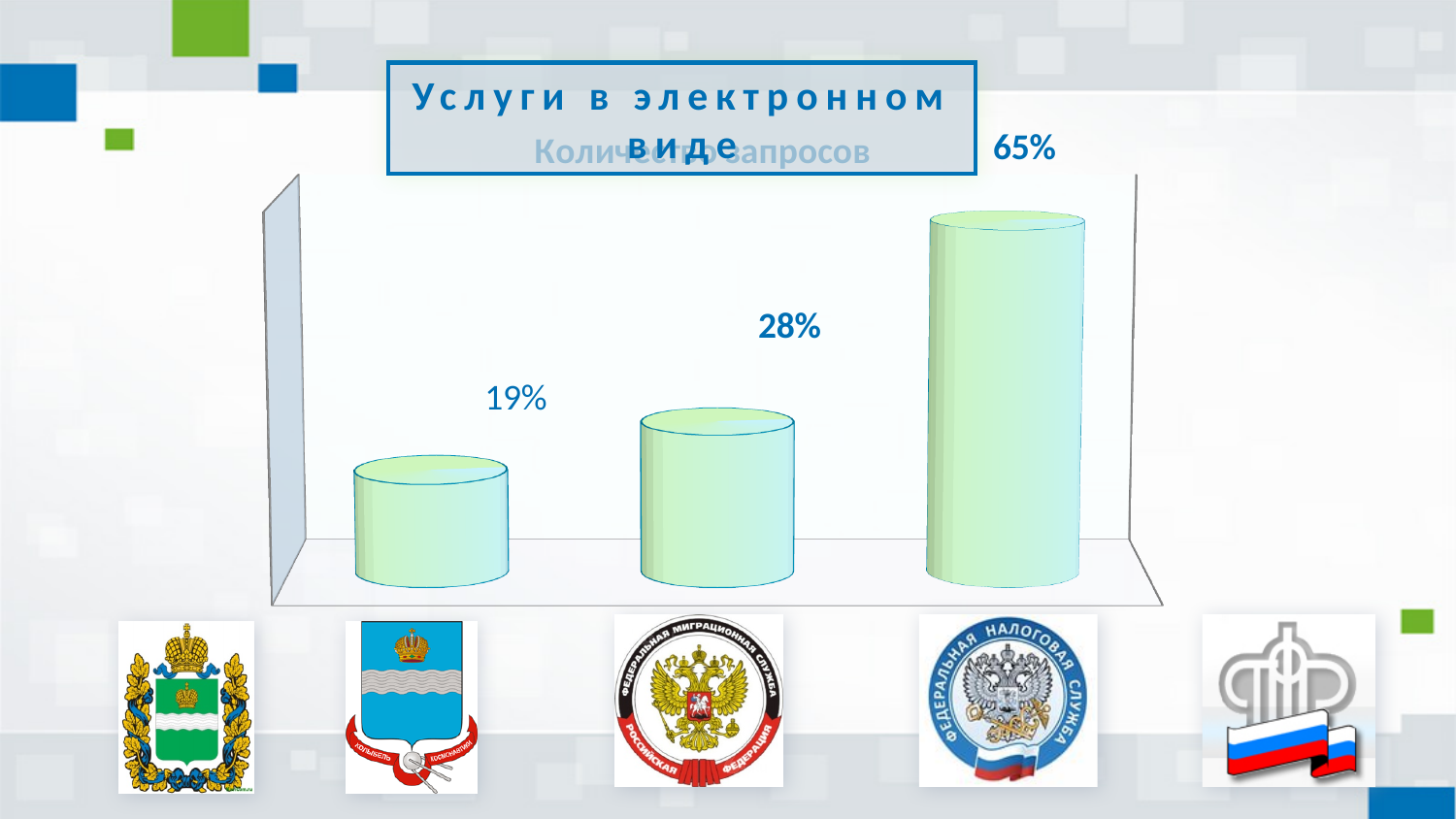
What is the value shown for the rightmost bar? 65% What is the difference between the rightmost bar's value and the middle bar's value? 37% Which bar has the lowest value: the left, middle or right one? left Which is larger, the value of the middle bar or the value of the leftmost bar? the middle bar Which bar has the highest value: the left, middle or right one? right What is the difference between the middle bar's value and the leftmost bar's value? 9% What is the value shown for the leftmost bar? 19% Do the bar values rise or fall from left to right? rise What is the value shown for the middle bar? 28% What kind of chart is shown on the slide? bar chart What is the title of the chart? Количество запросов How many bars are plotted in the chart? 3